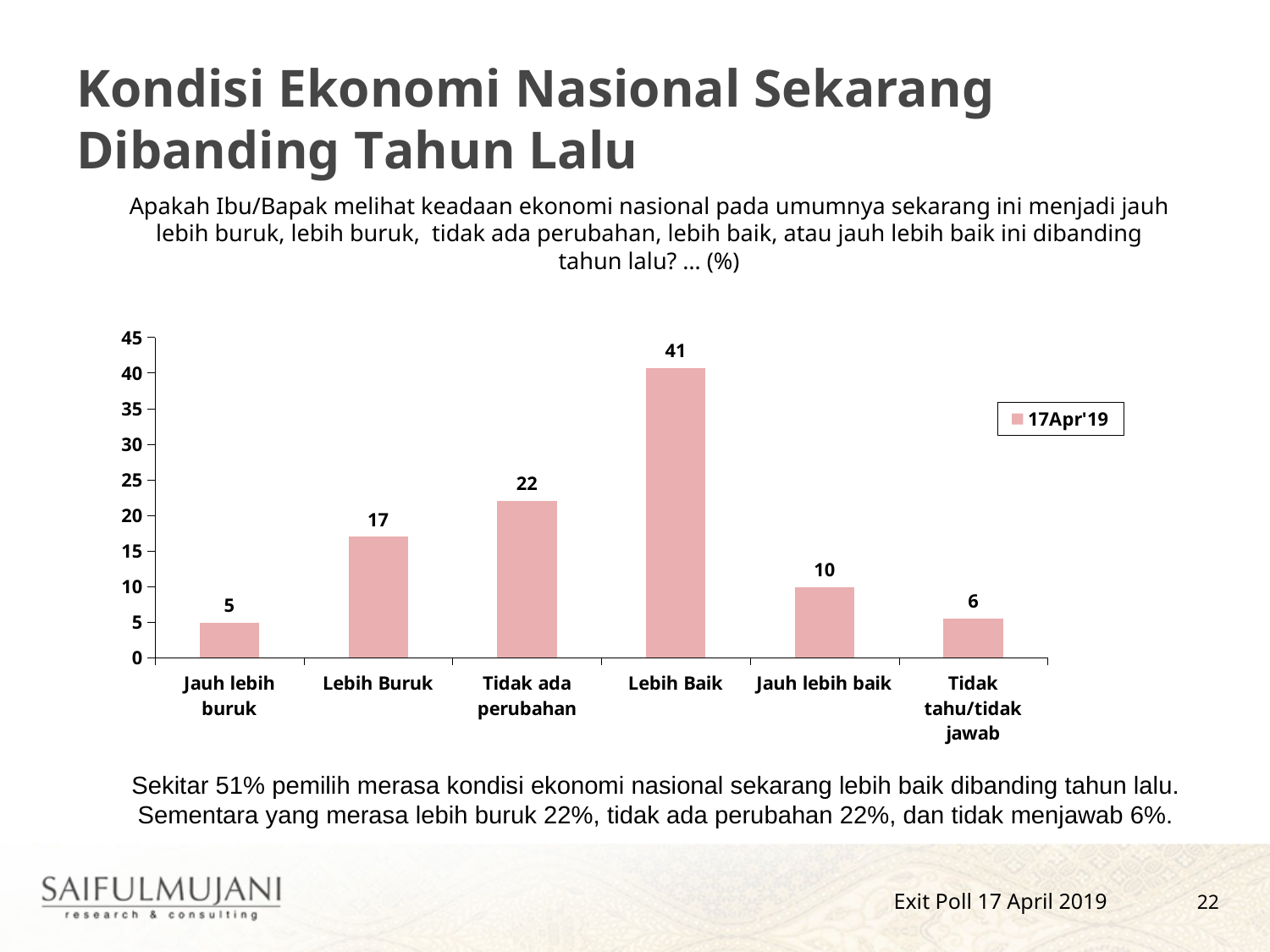
What is the value for "Lebih Baik"? 41 What kind of chart is shown on the slide? bar chart Which category has the lowest value? Jauh lebih buruk Is the value for "Lebih Baik" greater or less than 35? greater Which is larger, the value for "Lebih Buruk" or the value for "Jauh lebih baik"? Lebih Buruk What is the difference between the values for "Lebih Buruk" and "Jauh lebih baik"? 7 What is the value for "Tidak tahu/tidak jawab"? 6 Which category has the highest value? Lebih Baik What series name does the legend show? 17Apr'19 How many categories are shown on the x axis? 6 What is the value for "Jauh lebih buruk"? 5 What is the difference between the values for "Lebih Baik" and "Tidak ada perubahan"? 19